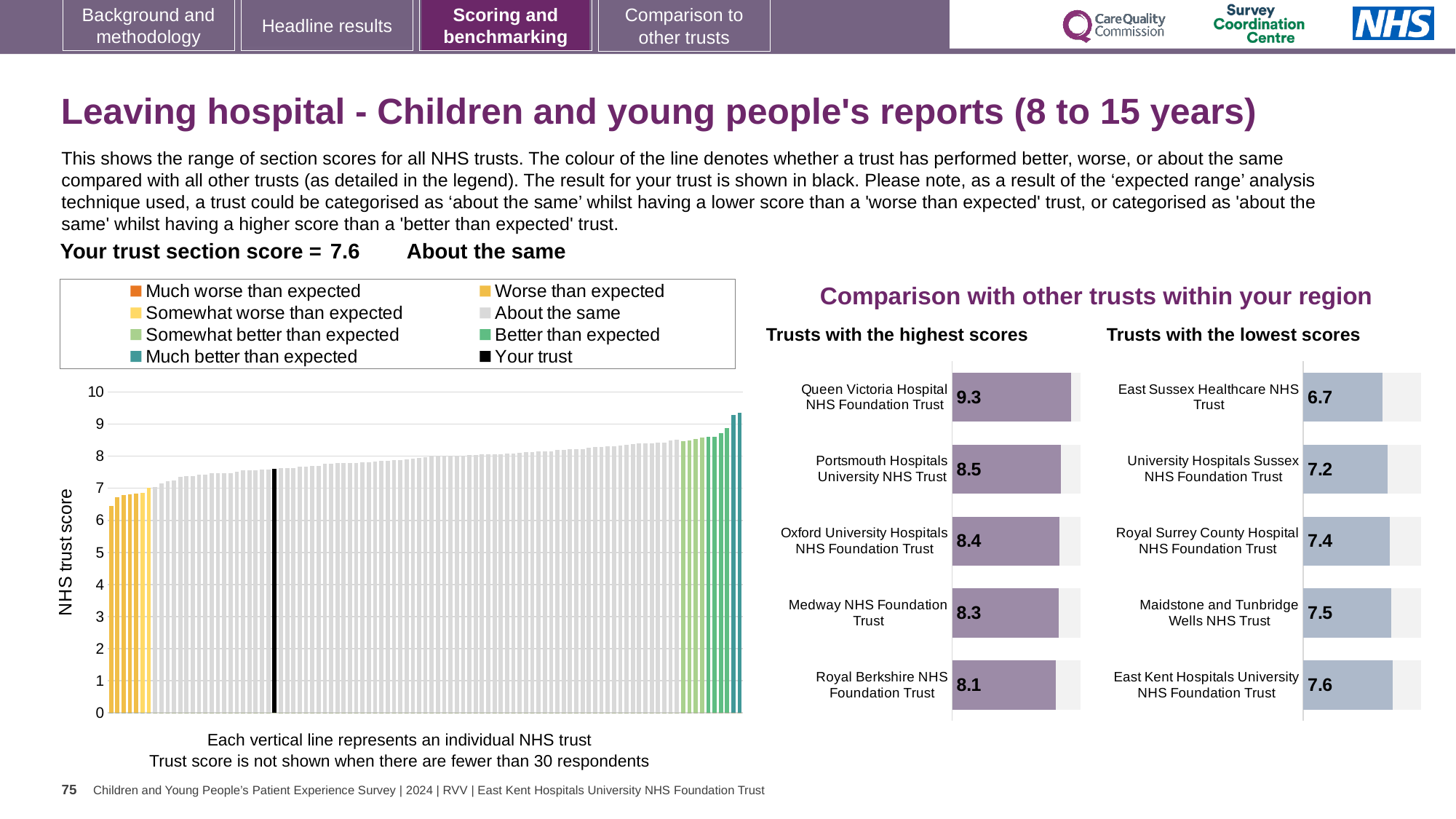
How many trusts are shown in the 'Trusts with the highest scores' chart? 5 In the large chart on the left, what is the section score for your trust (the black bar)? 7.6 In the 'Trusts with the lowest scores' chart, what is the score for Royal Surrey County Hospital NHS Foundation Trust? 7.4 In the large chart on the left, is the value of the tallest bar greater or less than 9? greater In the 'Trusts with the highest scores' chart, which trust has the highest score? Queen Victoria Hospital NHS Foundation Trust In the 'Trusts with the highest scores' chart, what is the score for Queen Victoria Hospital NHS Foundation Trust? 9.3 In the 'Trusts with the highest scores' chart, what is the difference between the scores of Queen Victoria Hospital NHS Foundation Trust and Royal Berkshire NHS Foundation Trust? 1.2 In the 'Trusts with the highest scores' chart, which has the higher score: Portsmouth Hospitals University NHS Trust or Oxford University Hospitals NHS Foundation Trust? Portsmouth Hospitals University NHS Trust What kind of chart is the large chart on the left showing the range of NHS trust scores? bar chart In the 'Trusts with the lowest scores' chart, which trust has the lowest score? East Sussex Healthcare NHS Trust In the 'Trusts with the lowest scores' chart, how much higher is East Kent Hospitals University NHS Foundation Trust's score than East Sussex Healthcare NHS Trust's score? 0.9 How many entries does the legend above the large chart on the left list? 8